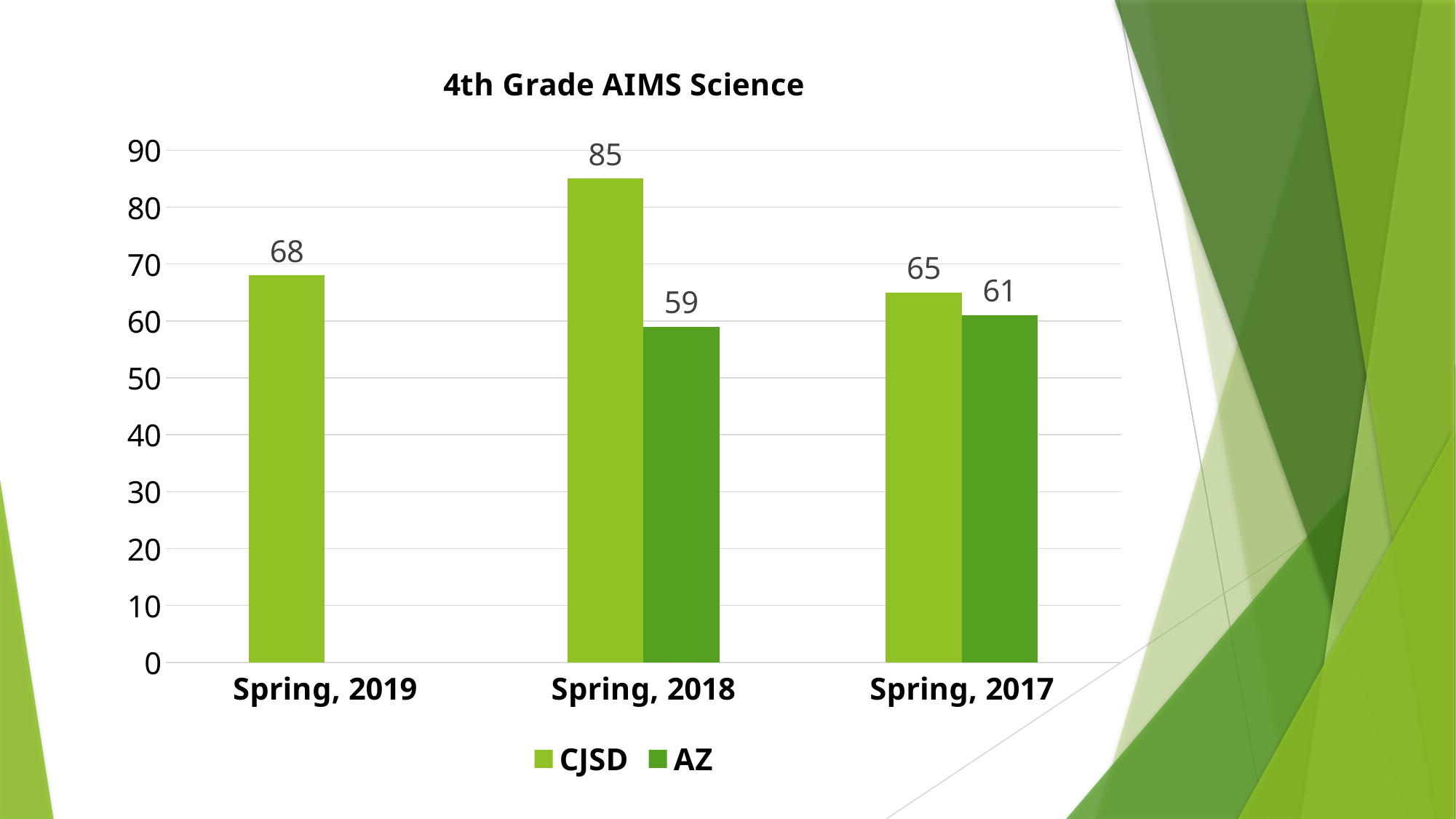
What is the AZ value for Spring, 2017? 61 What is the difference between the CJSD and AZ values for Spring, 2018? 26 What kind of chart is shown on the slide? Bar chart What is the CJSD value for Spring, 2018? 85 What is the AZ value for Spring, 2018? 59 For Spring, 2017, which is larger, CJSD or AZ? CJSD What is the CJSD value for Spring, 2019? 68 What is the title of the chart? 4th Grade AIMS Science How many series does the legend list? 2 How many categories are shown on the x axis? 3 Which category has the highest CJSD value? Spring, 2018 Which category has the lowest CJSD value? Spring, 2017